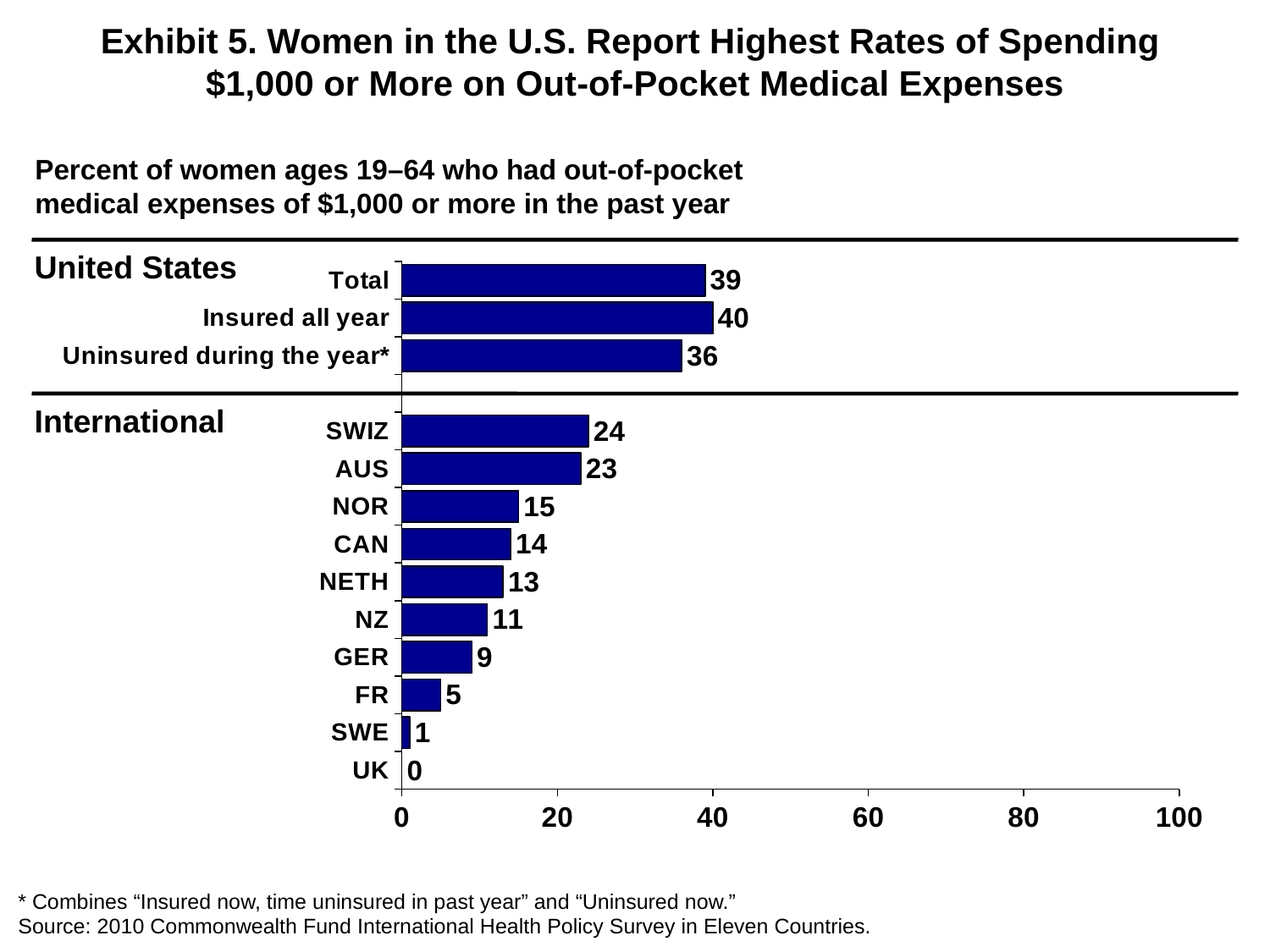
Which category has the highest value? Insured all year What is the value for Insured all year? 40 What is the difference between the values for GER and FR? 4 What is the value for SWIZ? 24 Which is larger, the value for NOR or the value for CAN? NOR What kind of chart is shown on the slide? Bar chart Which international country has the highest value? SWIZ How many categories are plotted in the chart? 13 What is the value for SWE? 1 What is the difference between the values for Total and SWIZ? 15 What is the value for Uninsured during the year*? 36 Which category has the lowest value? UK